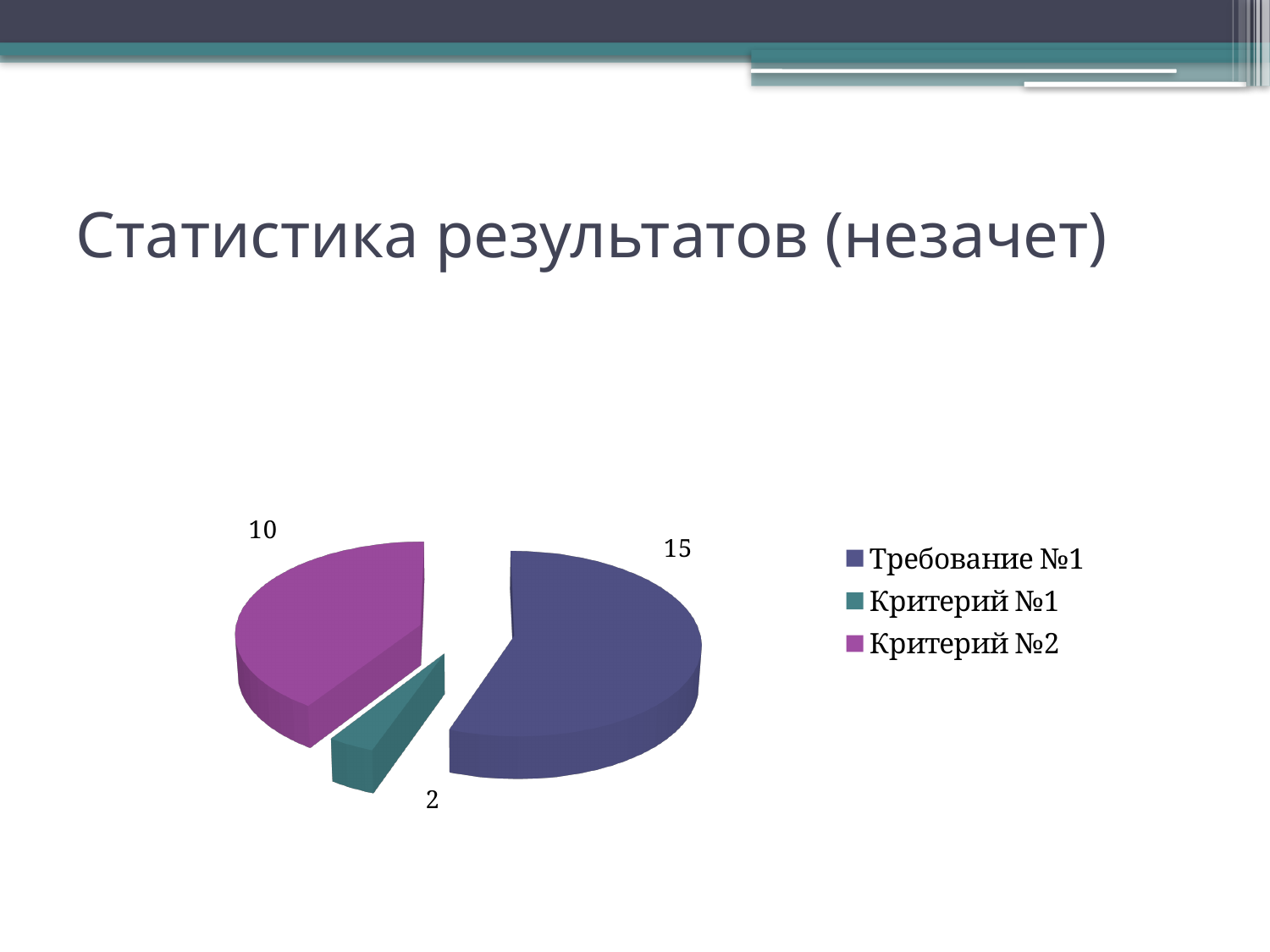
What is the value for Критерий №2? 10 What is the value for Требование №1? 15 What is the value for Критерий №1? 2 How many slices does the pie chart have? 3 What is the total of all the values shown in the pie chart? 27 What is the difference between the values for Критерий №2 and Критерий №1? 8 Which category has the largest slice of the pie? Требование №1 What is the title of the slide containing the chart? Статистика результатов (незачет) What is the difference between the values for Требование №1 and Критерий №2? 5 Which is larger, the value for Критерий №2 or the value for Критерий №1? Критерий №2 What kind of chart is shown on the slide? pie chart Which category has the smallest slice of the pie? Критерий №1